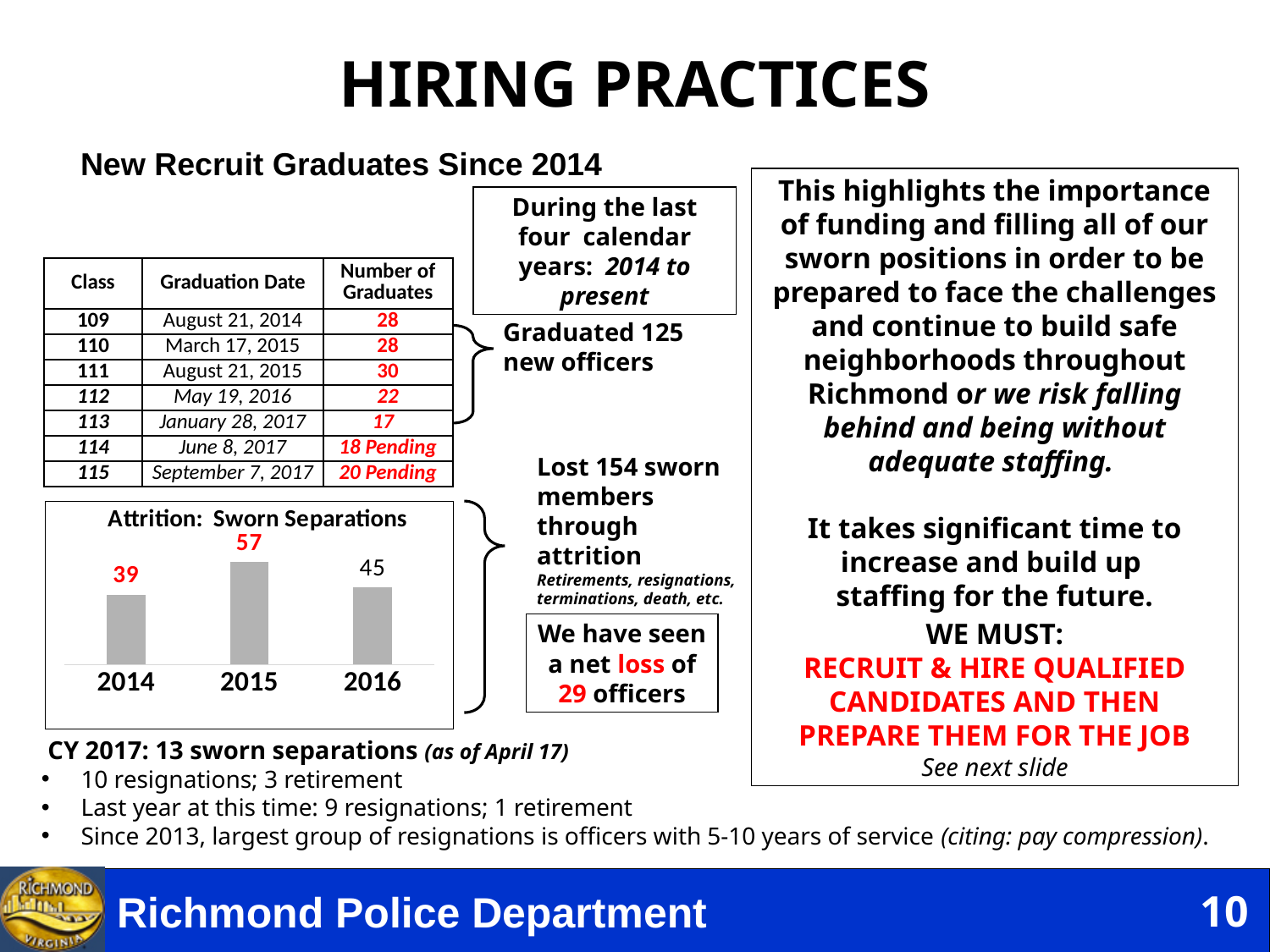
In the 'Attrition: Sworn Separations' chart, what is the difference between the 2015 and 2016 values? 12 In the 'Attrition: Sworn Separations' chart, which year has the highest number of sworn separations? 2015 How many years are shown in the 'Attrition: Sworn Separations' chart? 3 In the 'Attrition: Sworn Separations' chart, what is the difference between the 2015 and 2014 values? 18 What is the title of the chart on the slide? Attrition: Sworn Separations In the 'Attrition: Sworn Separations' chart, what is the value for 2016? 45 In the 'Attrition: Sworn Separations' chart, which year has the lowest number of sworn separations? 2014 In the 'Attrition: Sworn Separations' chart, what is the value for 2015? 57 In the 'Attrition: Sworn Separations' chart, what is the value for 2014? 39 In the 'Attrition: Sworn Separations' chart, do the values rise or fall from 2015 to 2016? fall In the 'Attrition: Sworn Separations' chart, which is larger, the value for 2016 or the value for 2014? 2016 What type of chart is 'Attrition: Sworn Separations'? bar chart